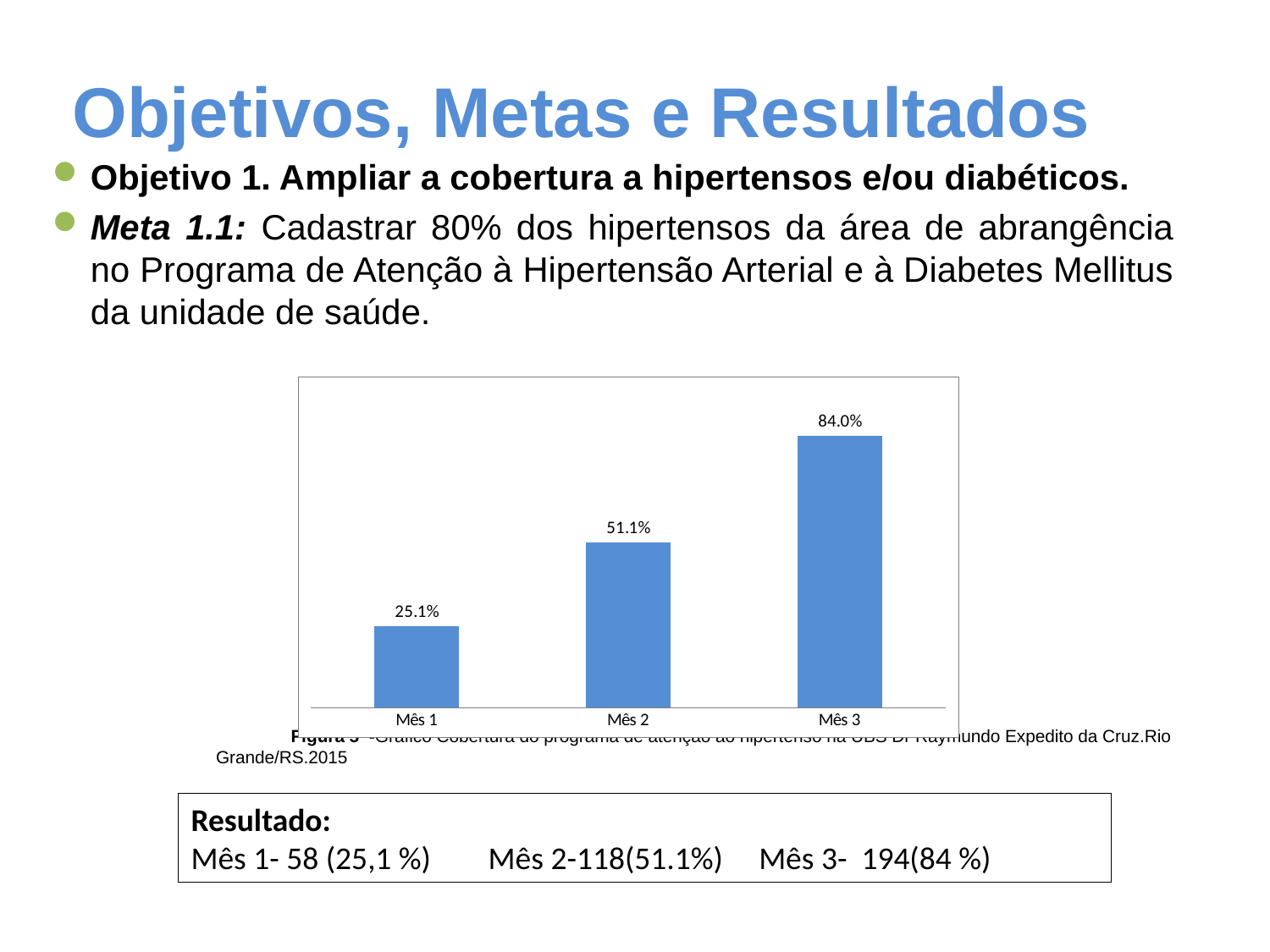
Which is larger, the value for Mês 2 or the value for Mês 3? Mês 3 How many categories are shown on the x axis? 3 Which month has the lowest value? Mês 1 Which month has the highest value? Mês 3 What is the value for Mês 1? 25.1% What is the difference between the values for Mês 2 and Mês 1? 26.0% What is the value for Mês 2? 51.1% What kind of chart is this? bar chart What is the value for Mês 3? 84.0% What is the difference between the values for Mês 3 and Mês 1? 58.9% What colour are the bars in the chart? blue Do the values rise or fall from Mês 1 to Mês 3? rise